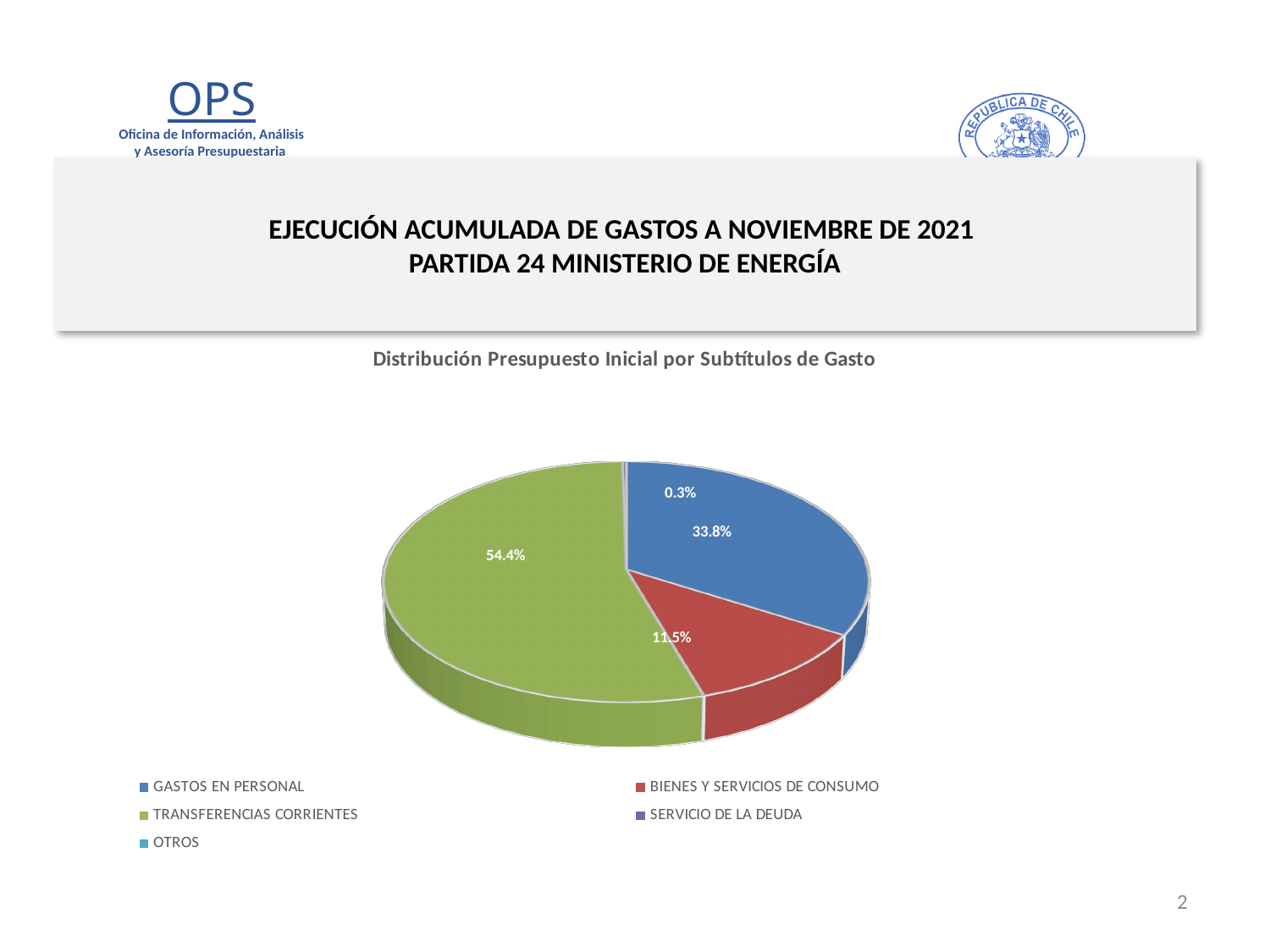
What percentage of the pie does BIENES Y SERVICIOS DE CONSUMO represent? 11.5% How many categories does the legend list? 5 Which is larger, the share for GASTOS EN PERSONAL or the share for BIENES Y SERVICIOS DE CONSUMO? GASTOS EN PERSONAL What is the title of the chart? Distribución Presupuesto Inicial por Subtítulos de Gasto Is the share for TRANSFERENCIAS CORRIENTES greater or less than 50%? greater What kind of chart is shown on the slide? Pie chart What is the difference in percentage points between GASTOS EN PERSONAL and BIENES Y SERVICIOS DE CONSUMO? 22.3 percentage points Which category has the largest share of the pie? TRANSFERENCIAS CORRIENTES What is the difference in percentage points between TRANSFERENCIAS CORRIENTES and GASTOS EN PERSONAL? 20.6 percentage points What percentage of the pie does TRANSFERENCIAS CORRIENTES represent? 54.4% What percentage of the pie does GASTOS EN PERSONAL represent? 33.8% What is the smallest percentage label shown on the pie? 0.3%